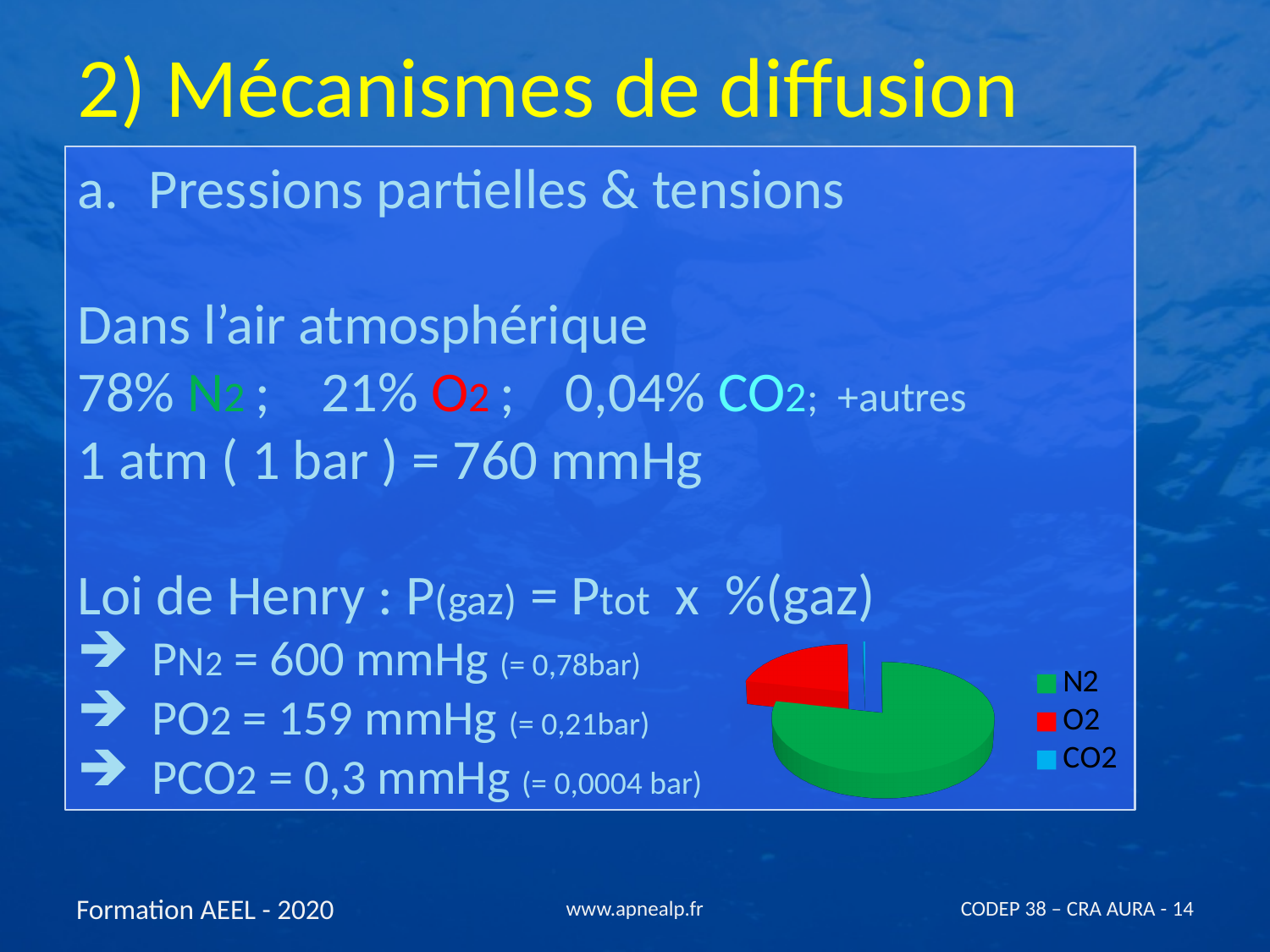
How many entries does the legend of the pie chart list? 3 Which gas has the smallest slice in the pie chart? CO2 In the pie chart, which slice is larger, N2 or O2? N2 How many slices does the pie chart have? 3 What colour is the N2 slice in the pie chart? green What kind of chart is shown on the slide? pie chart Which gas has the largest slice in the pie chart? N2 In the pie chart, which slice is larger, O2 or CO2? O2 What colour is the O2 slice in the pie chart? red